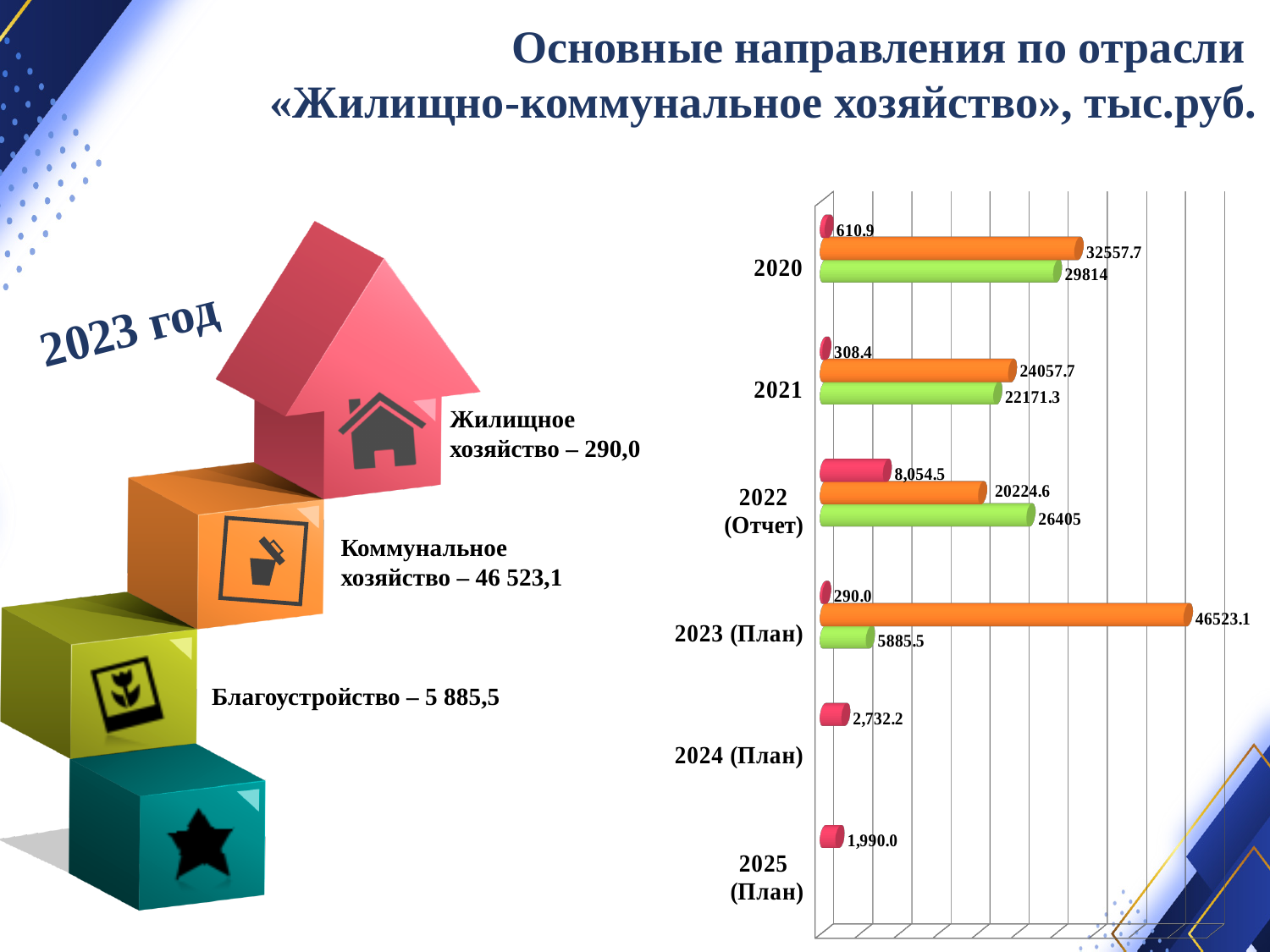
For 2022 (Отчет), which is larger: the orange bar or the green bar? the green bar How many year categories are shown on the chart? 6 What is the value of the red bar for 2025 (План)? 1,990.0 What is the value of the red bar for 2024 (План)? 2,732.2 In which year does the orange series reach its highest value? 2023 (План) What is the value of the orange bar for 2023 (План)? 46523.1 What is the difference between the orange and green values for 2021? 1886.4 What is the value of the red bar for 2022 (Отчет)? 8,054.5 What is the value of the green bar for 2020? 29814 In which year is the red series at its lowest value? 2023 (План) What is the difference between the orange and green values for 2020? 2743.7 What type of chart is shown on the slide? bar chart